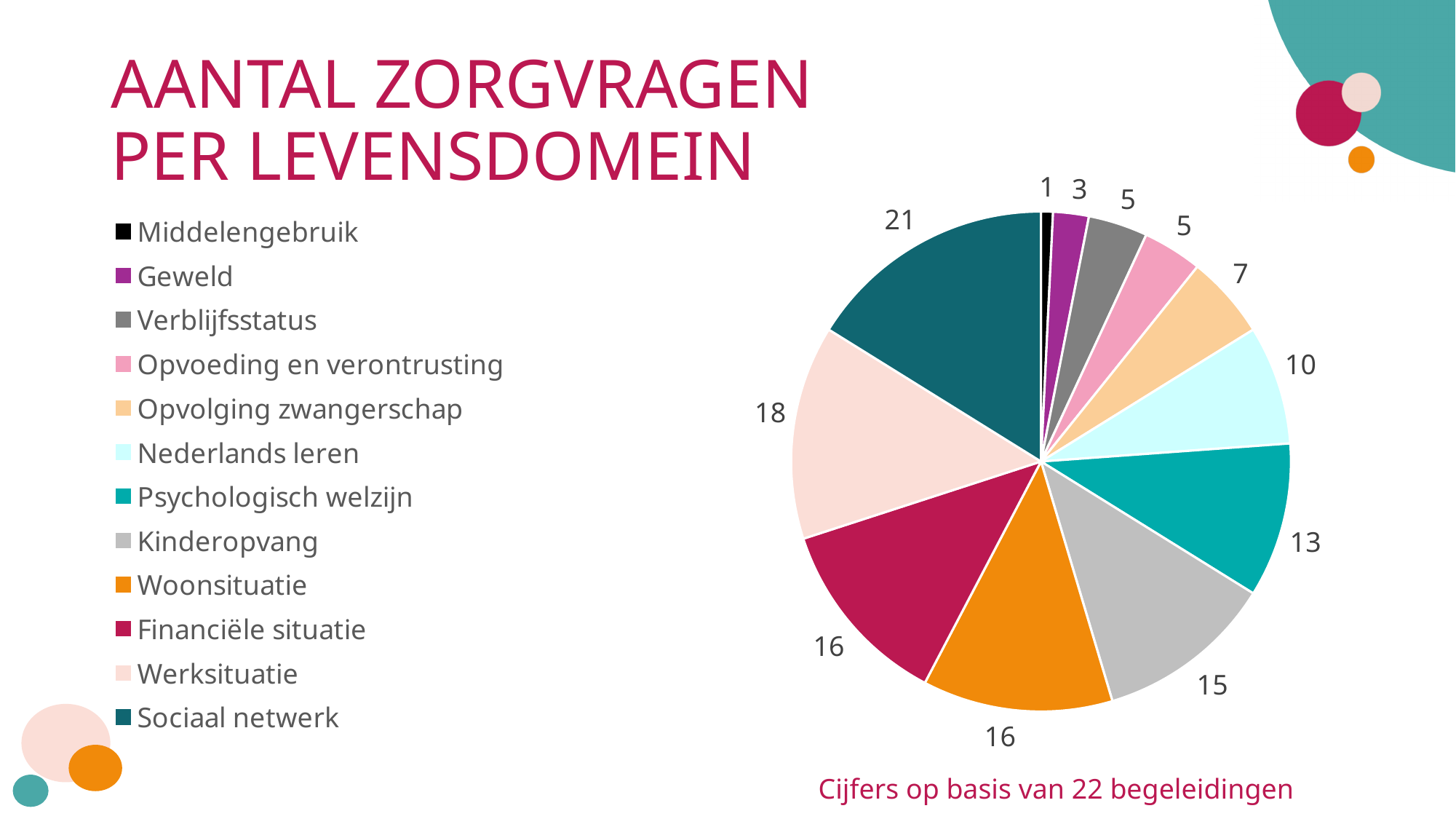
Which category has the highest value? Sociaal netwerk What is the value for Sociaal netwerk? 21 What kind of chart is shown on the slide? pie chart Which is larger, the value for Psychologisch welzijn or the value for Kinderopvang? Kinderopvang What is the difference between the values for Sociaal netwerk and Werksituatie? 3 What is the value for Psychologisch welzijn? 13 What is the value for Opvolging zwangerschap? 7 How many categories does the pie chart show? 12 What is the difference between the values for Kinderopvang and Nederlands leren? 5 Which category has the lowest value? Middelengebruik What is the value for Werksituatie? 18 What is the title of the slide containing the chart? AANTAL ZORGVRAGEN PER LEVENSDOMEIN